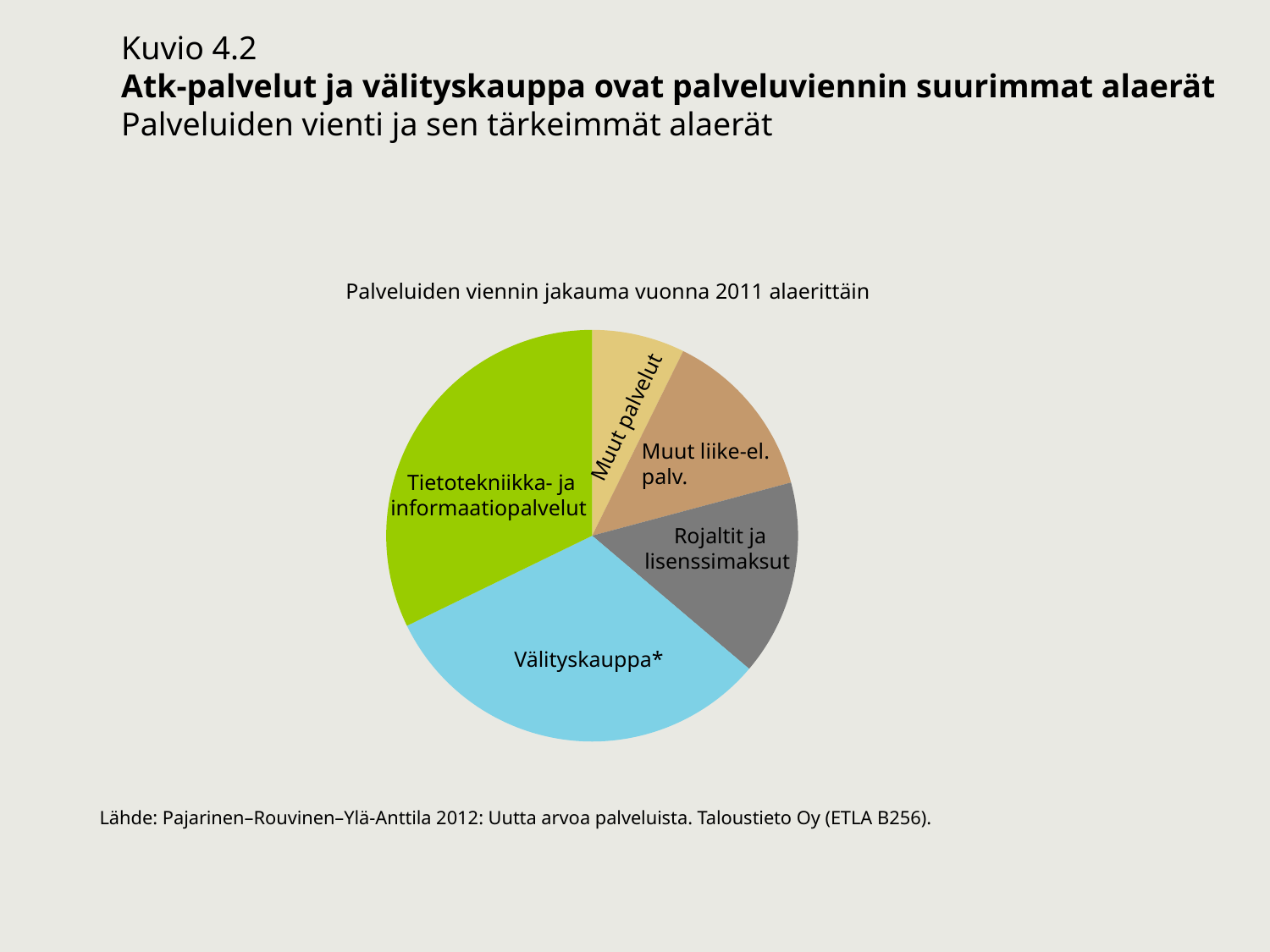
How many slices does the pie chart have? 5 Which is larger in the pie chart, Tietotekniikka- ja informaatiopalvelut or Rojaltit ja lisenssimaksut? Tietotekniikka- ja informaatiopalvelut Which is larger in the pie chart, Muut palvelut or Rojaltit ja lisenssimaksut? Rojaltit ja lisenssimaksut Which slice of the pie chart is the smallest? Muut palvelut Which is larger in the pie chart, Välityskauppa* or Muut liike-el. palv.? Välityskauppa* What colour is the Välityskauppa* slice in the pie chart? blue What is the title of the pie chart? Palveluiden viennin jakauma vuonna 2011 alaerittäin What kind of chart is shown on the slide? pie chart